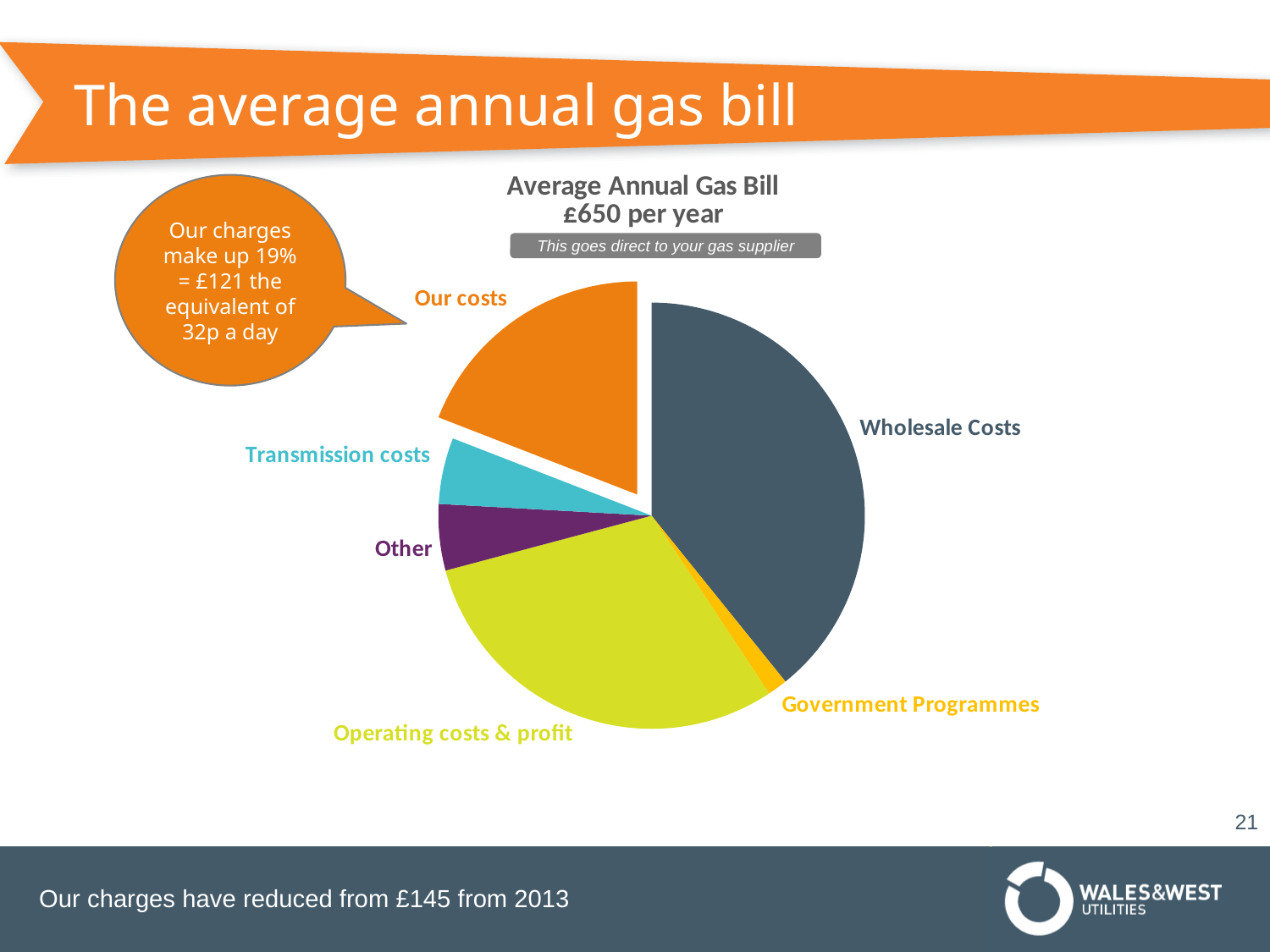
Which slice is larger: Wholesale Costs or Operating costs & profit? Wholesale Costs What kind of chart is shown on the slide? Pie chart What is the title of the pie chart? Average Annual Gas Bill £650 per year Which category has the smallest slice of the pie chart? Government Programmes Which category has the largest slice of the pie chart? Wholesale Costs Which slice is larger: Other or Government Programmes? Other Which slice is pulled out (exploded) from the rest of the pie chart? Our costs Which slice is larger: Our costs or Transmission costs? Our costs According to the slide, what share of the average annual gas bill is made up by Our costs (our charges)? 19% How many categories (slices) does the pie chart have? 6